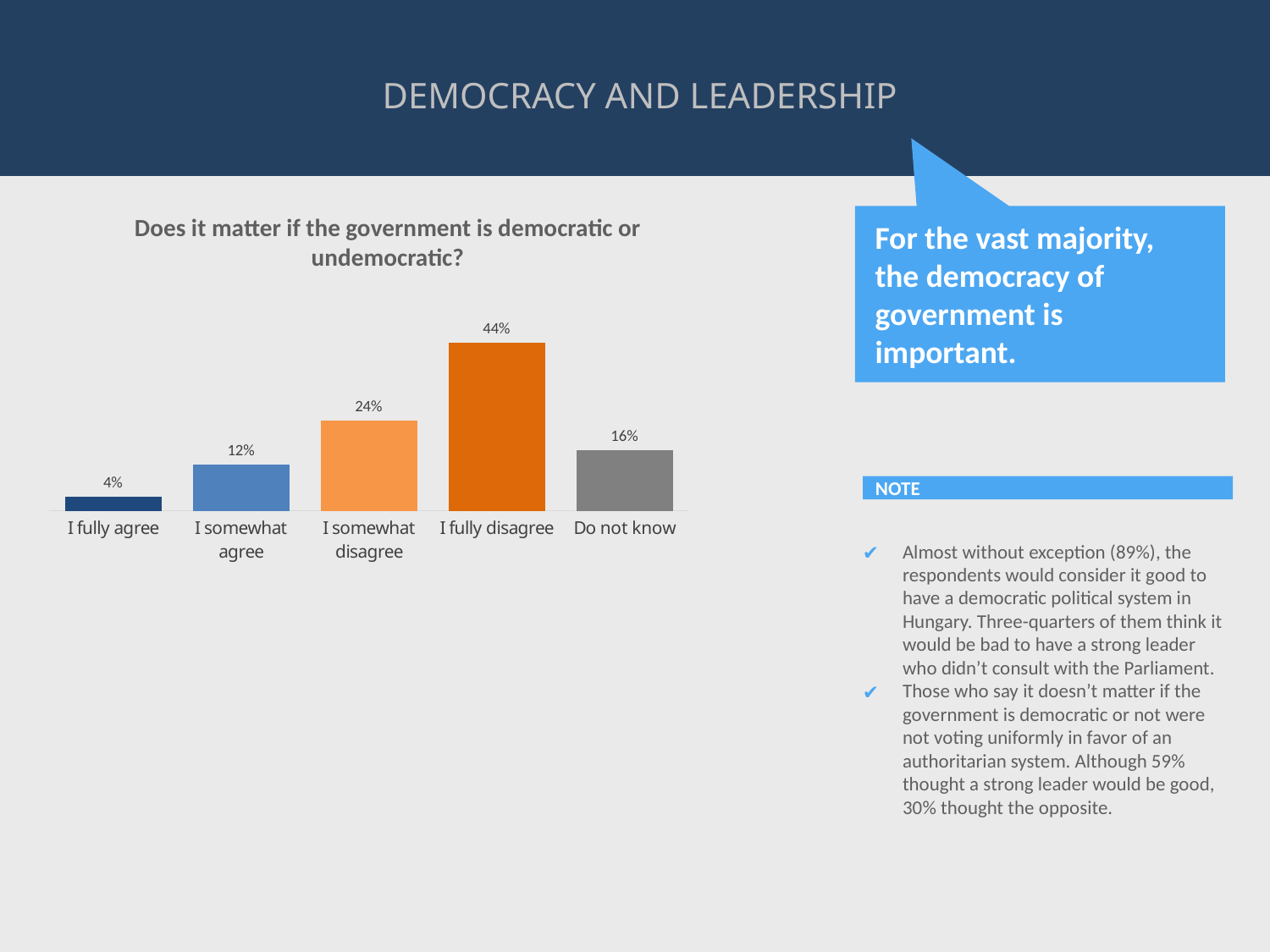
Which response category has the lowest value? I fully agree What is the difference between "I fully disagree" and "I somewhat disagree"? 20% How many response categories are shown in the chart? 5 What is the title of the chart? Does it matter if the government is democratic or undemocratic? What percentage answered "Do not know"? 16% What is the value for "I somewhat disagree"? 24% Which is larger, "I somewhat agree" or "Do not know"? Do not know What is the combined value of "I fully agree" and "I somewhat agree"? 16% What is the value for "I fully agree"? 4% Which response category has the highest value? I fully disagree What percentage of respondents answered "I fully disagree"? 44% What type of chart is used on the slide? Bar chart